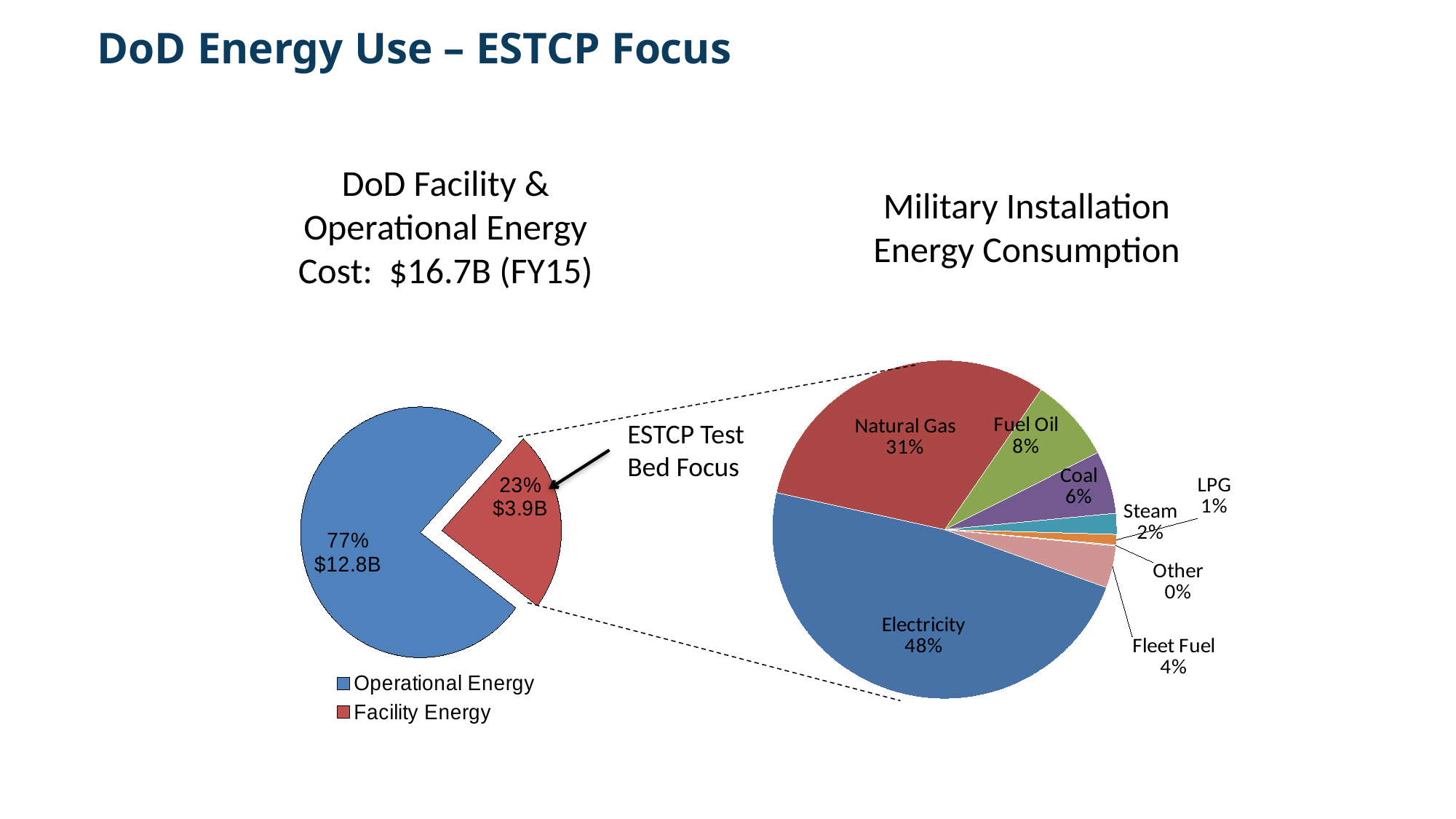
In the 'Military Installation Energy Consumption' pie chart, which category has the largest share? Electricity In the 'DoD Facility & Operational Energy Cost' pie chart, what dollar value is shown for Operational Energy? $12.8B In the 'DoD Facility & Operational Energy Cost' pie chart, what dollar value is shown for Facility Energy? $3.9B In the 'DoD Facility & Operational Energy Cost' pie chart, how many entries does the legend list? 2 In the 'DoD Facility & Operational Energy Cost' pie chart, which slice is labelled as the ESTCP Test Bed Focus? Facility Energy In the 'Military Installation Energy Consumption' pie chart, which is larger, Fuel Oil or Coal? Fuel Oil In the 'Military Installation Energy Consumption' pie chart, how many categories are shown? 8 In the 'Military Installation Energy Consumption' pie chart, what is the difference between the Electricity share and the Natural Gas share? 17% In the 'DoD Facility & Operational Energy Cost' pie chart, what share does Operational Energy have? 77% In the 'Military Installation Energy Consumption' pie chart, what share does Natural Gas have? 31% What kind of chart is the 'Military Installation Energy Consumption' chart? Pie chart In the 'Military Installation Energy Consumption' pie chart, which category has the smallest share? Other